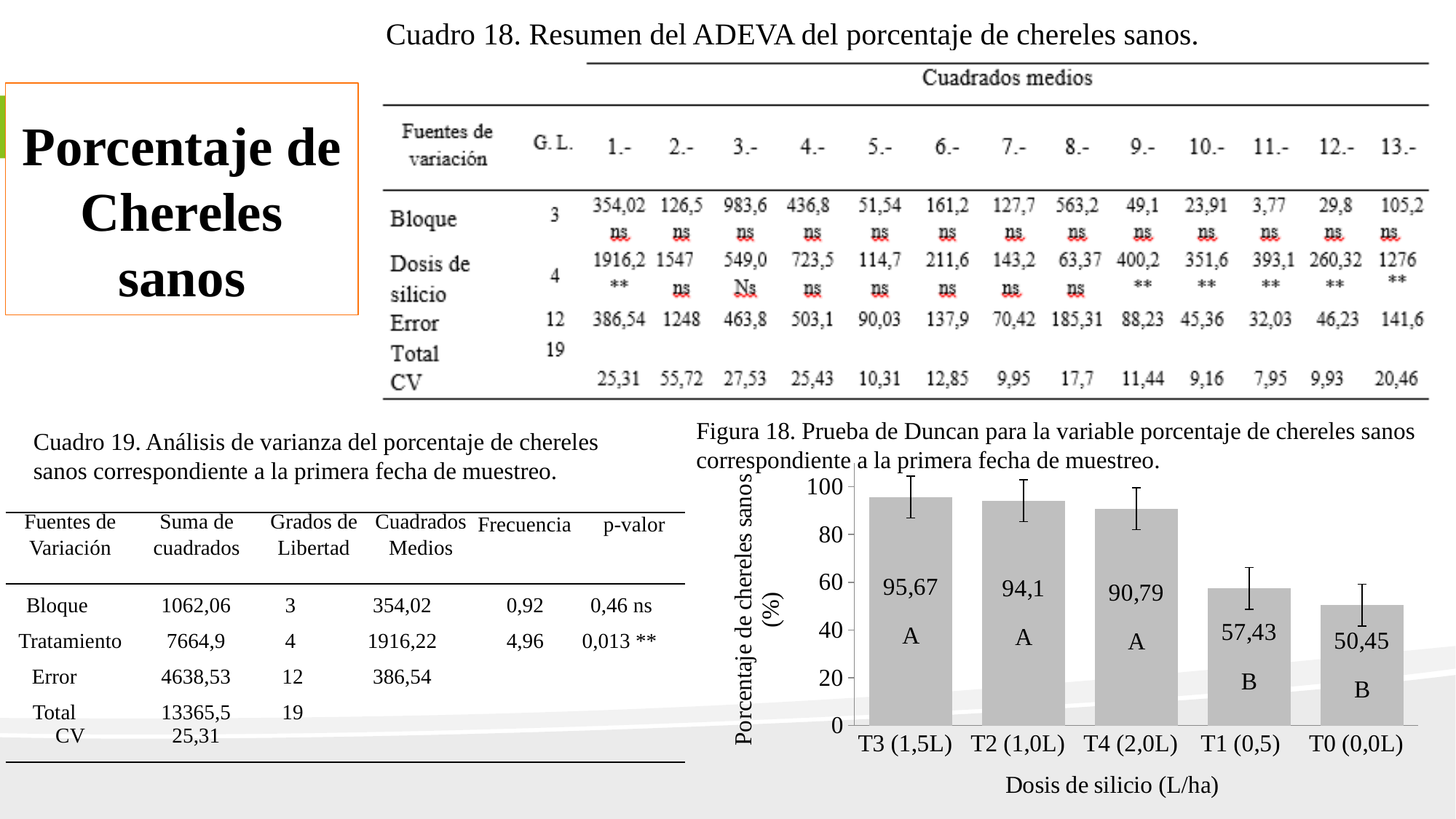
In Figura 18, which is larger, the value for T4 (2,0L) or the value for T1 (0,5)? T4 (2,0L) In Figura 18, what is the value for T3 (1,5L)? 95,67 What type of chart is shown in Figura 18? bar chart In Figura 18, do the bar values rise or fall from left to right along the x axis? fall In Figura 18, what is the difference between the values for T1 (0,5) and T0 (0,0L)? 6,98 In Figura 18, what is the value for T1 (0,5)? 57,43 How many bars are plotted in Figura 18? 5 In Figura 18, is the value for T2 (1,0L) greater or less than 80? greater In Figura 18, which dose has the highest percentage of healthy chereles? T3 (1,5L) In Figura 18, which dose has the lowest percentage of healthy chereles? T0 (0,0L) In Figura 18, what is the value for T0 (0,0L)? 50,45 In Figura 18, what is the difference between the values for T3 (1,5L) and T0 (0,0L)? 45,22